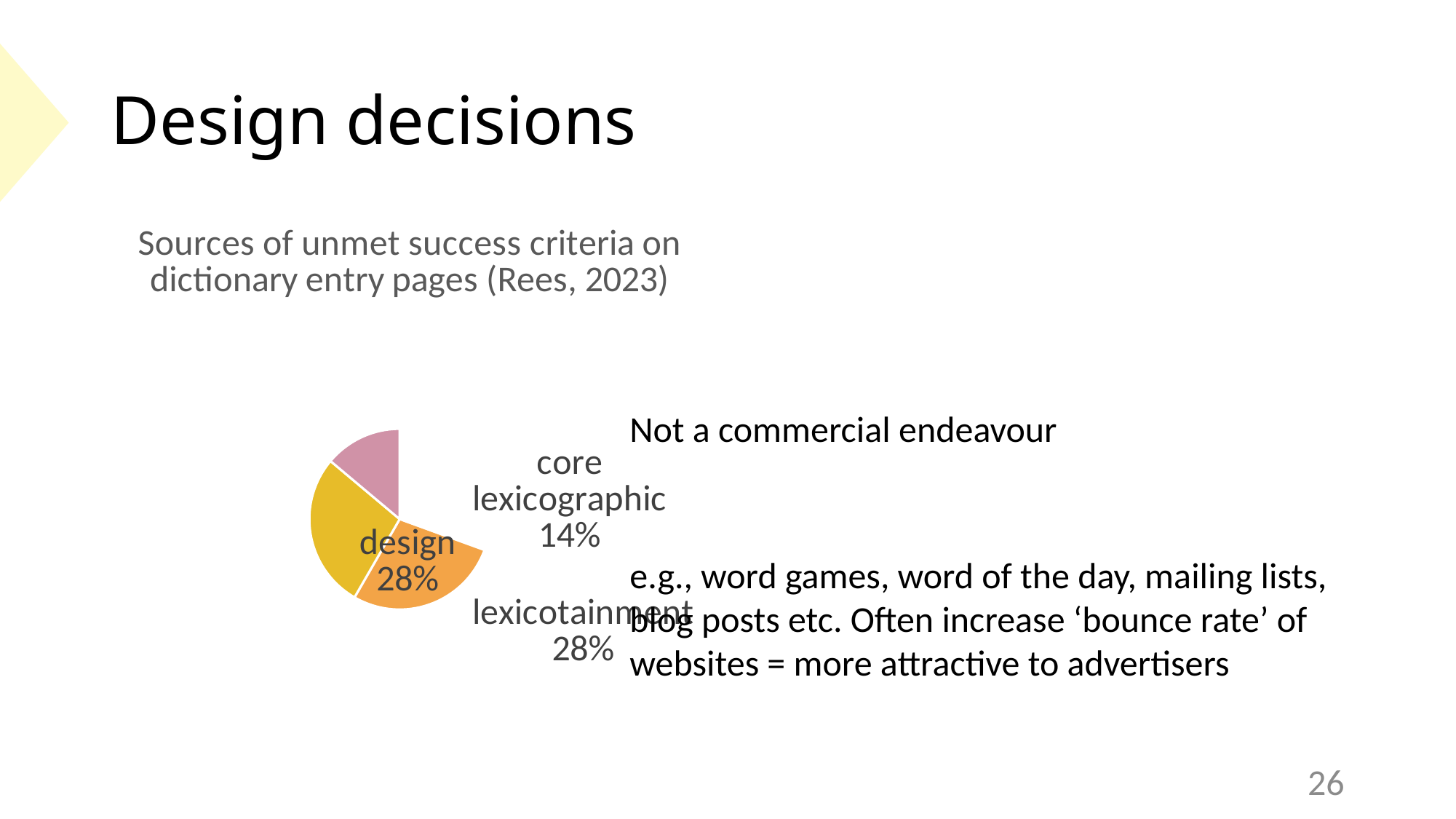
Which labelled slice of the pie chart has the smallest share? core lexicographic What colour is the core lexicographic slice in the pie chart? pink What is the difference in percentage points between the lexicotainment slice and the core lexicographic slice? 14 What is the difference in percentage points between the design slice and the lexicotainment slice? 0 What percentage does the lexicotainment slice represent in the pie chart? 28% What type of chart is shown on the slide? pie chart Which is larger in the pie chart, the design slice or the core lexicographic slice? design How many labelled slices are shown in the pie chart? 3 What is the title of the chart on the slide? Sources of unmet success criteria on dictionary entry pages (Rees, 2023) What percentage does the design slice represent in the pie chart? 28% What percentage does the core lexicographic slice represent in the pie chart? 14%